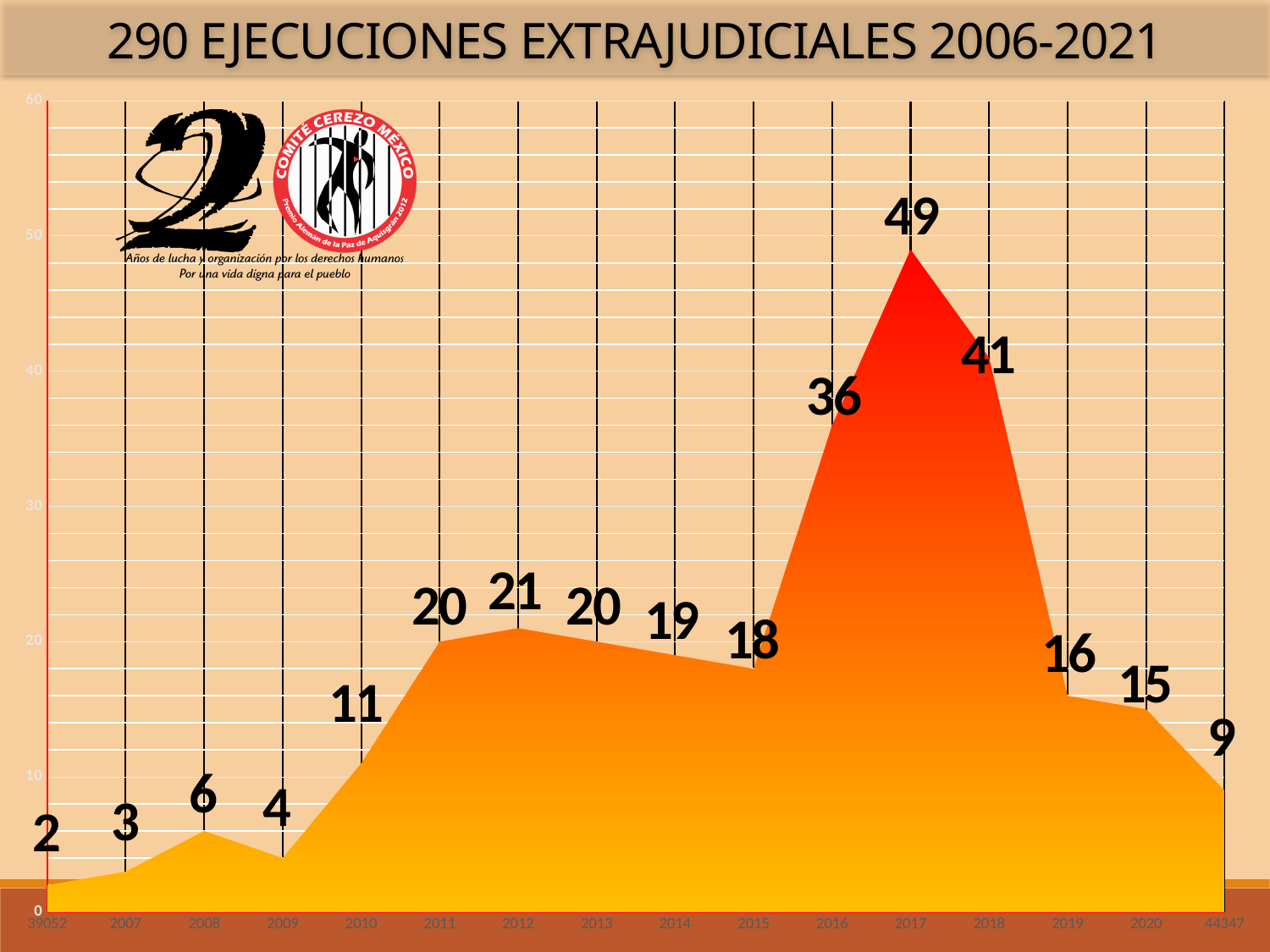
Which is larger, the value for 2016 or the value for 2018? 2018 What is the value for 2019? 16 Is the value for 2016 greater or less than 30? greater Which year has the highest value? 2017 How many data points are plotted on the chart? 16 Do the values rise or fall from 2017 to 2020? fall What kind of chart is shown? area chart What is the value for 2017? 49 What is the difference between the values for 2017 and 2018? 8 What is the value for 2012? 21 What is the lowest value shown on the chart? 2 What is the value for 2010? 11